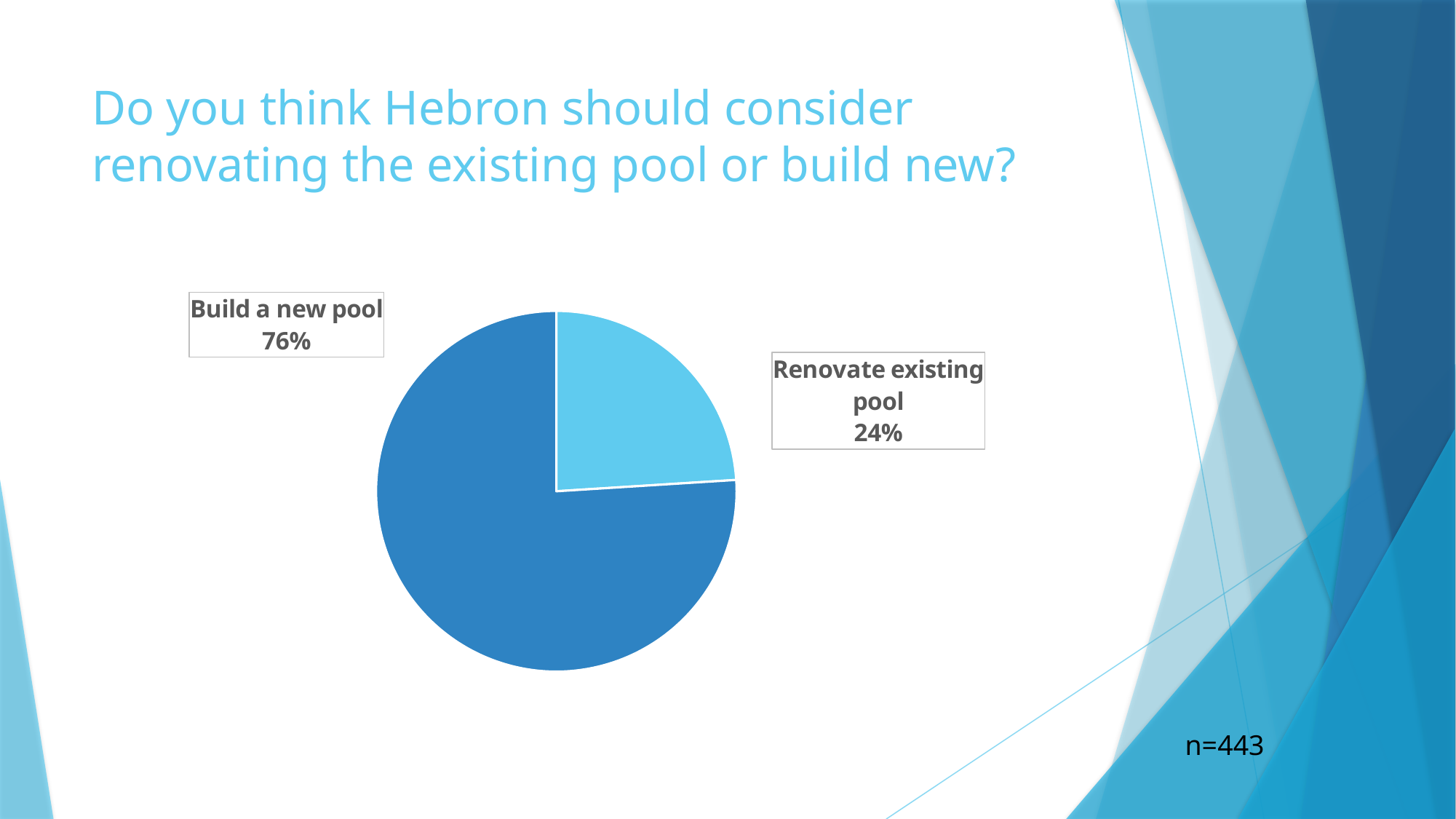
What is the sample size (n) shown on the slide? 443 What question does the slide title ask? Do you think Hebron should consider renovating the existing pool or build new? What is the difference in percentage points between "Build a new pool" and "Renovate existing pool"? 52 What kind of chart is shown on the slide? pie chart What share of respondents chose "Build a new pool"? 76% What share of respondents chose "Renovate existing pool"? 24% How many slices does the pie chart have? 2 Which is larger: the share for "Build a new pool" or the share for "Renovate existing pool"? Build a new pool Which option has the smallest share of the pie? Renovate existing pool Which option has the largest share of the pie? Build a new pool